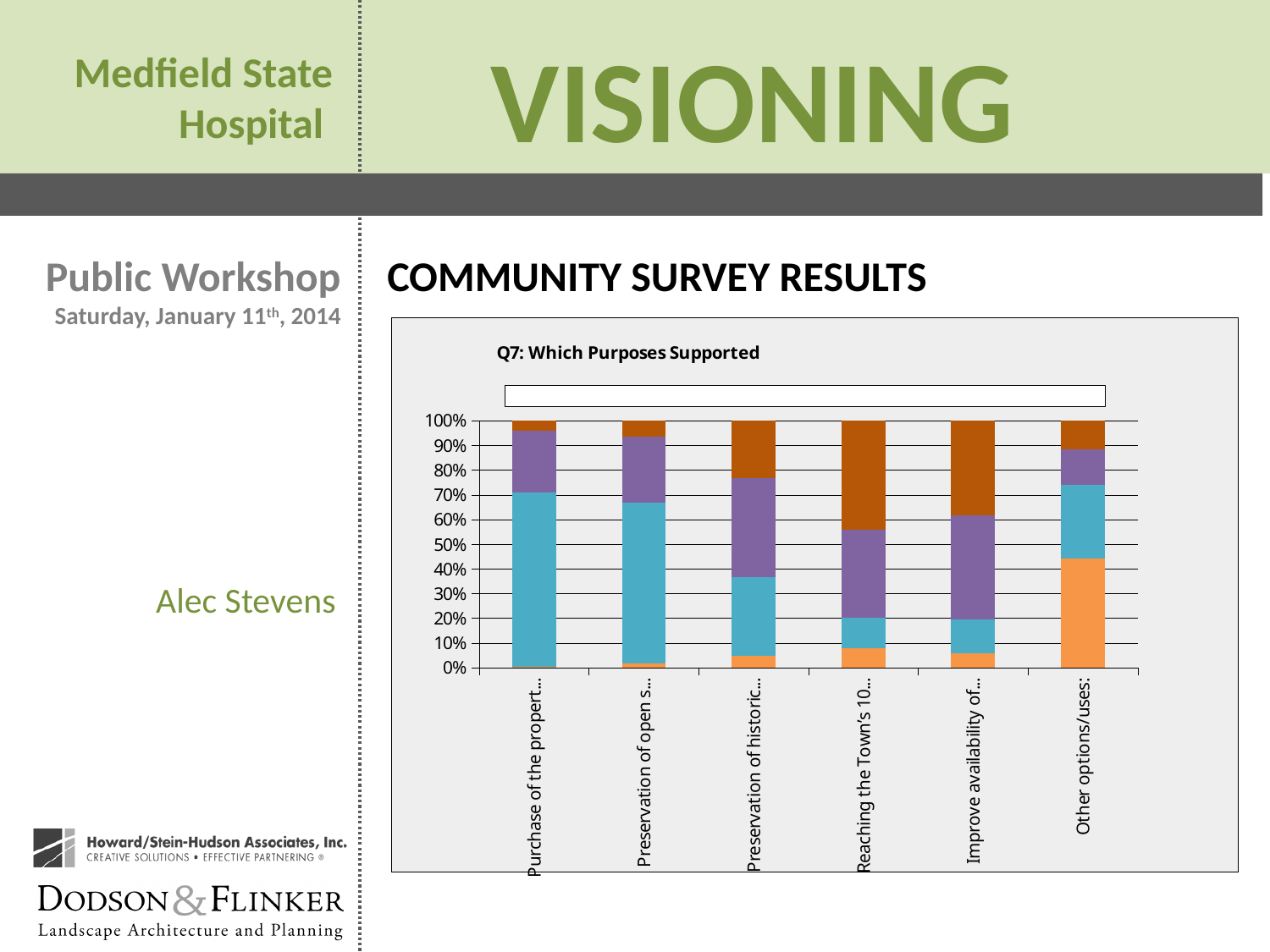
Is the top of the purple segment for "Preservation of open s..." greater or less than 90%? greater What type of chart is shown on the slide? Stacked bar chart Which category has the largest bottom (orange) segment? Other options/uses: Is the top of the teal segment for "Reaching the Town's 10..." greater or less than 30%? less Is the teal segment larger for the first bar ("Purchase of the propert...") or for "Other options/uses:"? Purchase of the propert... What is the title of the chart? Q7: Which Purposes Supported Is the top of the bottom (orange) segment for "Other options/uses:" greater or less than 30%? greater How many coloured segments make up each stacked bar? 4 Which category has the largest top (brown) segment? Reaching the Town's 10... Is the brown segment larger for "Purchase of the propert..." or for "Improve availability of..."? Improve availability of... How many categories (bars) are shown on the x axis? 6